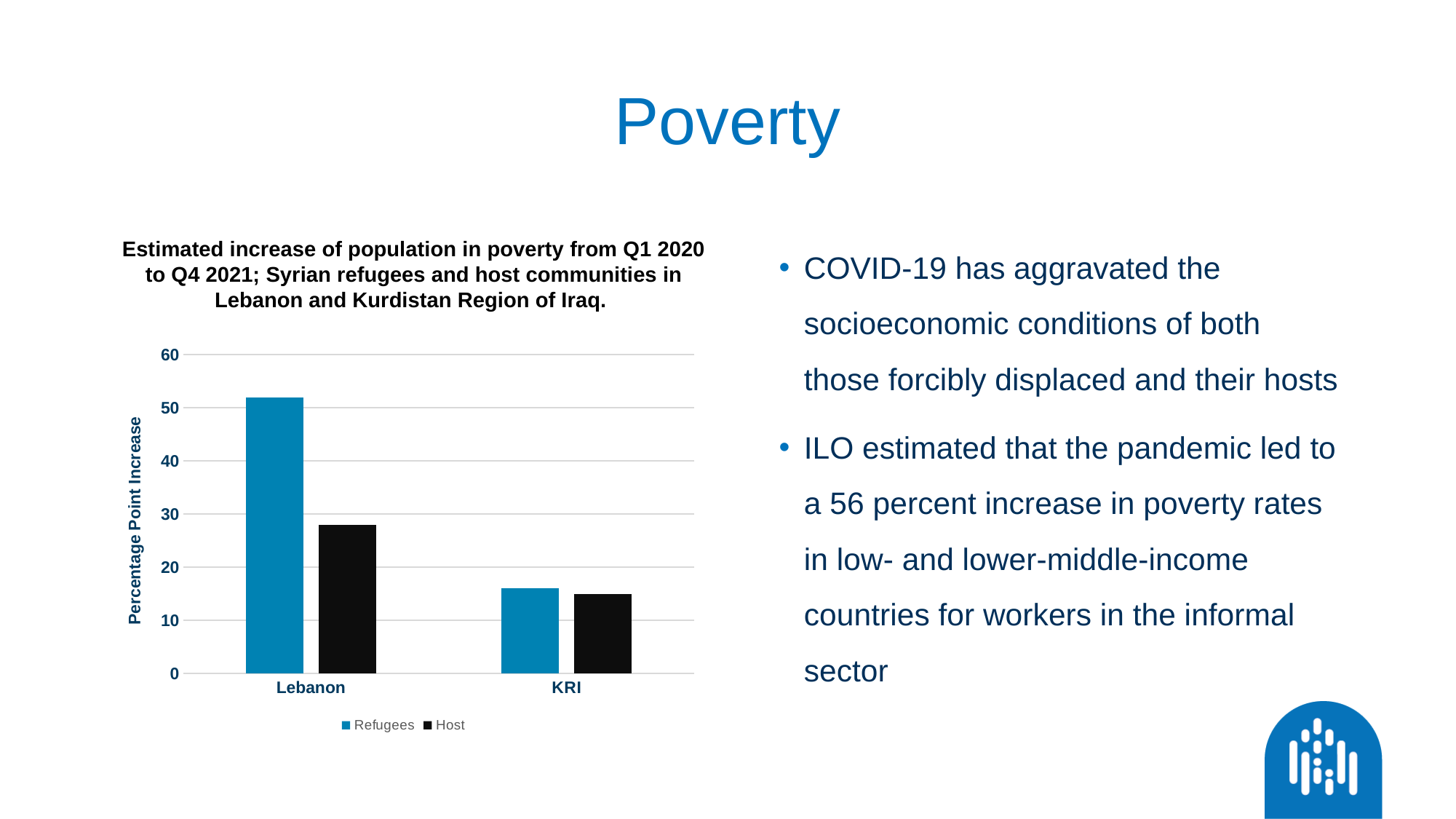
Is the Host value for Lebanon greater or less than 40? less Is the Refugees value for KRI greater or less than 20? less How many categories are shown on the x axis of the chart? 2 Which category has the higher Refugees value, Lebanon or KRI? Lebanon Is the Refugees value for Lebanon greater or less than 40? greater Which bar in the chart is the highest? Refugees in Lebanon Which category has the higher Host value, Lebanon or KRI? Lebanon In Lebanon, which series has the larger value, Refugees or Host? Refugees What is the label of the vertical axis of the chart? Percentage Point Increase What kind of chart is shown on the slide? bar chart How many series does the chart legend list? 2